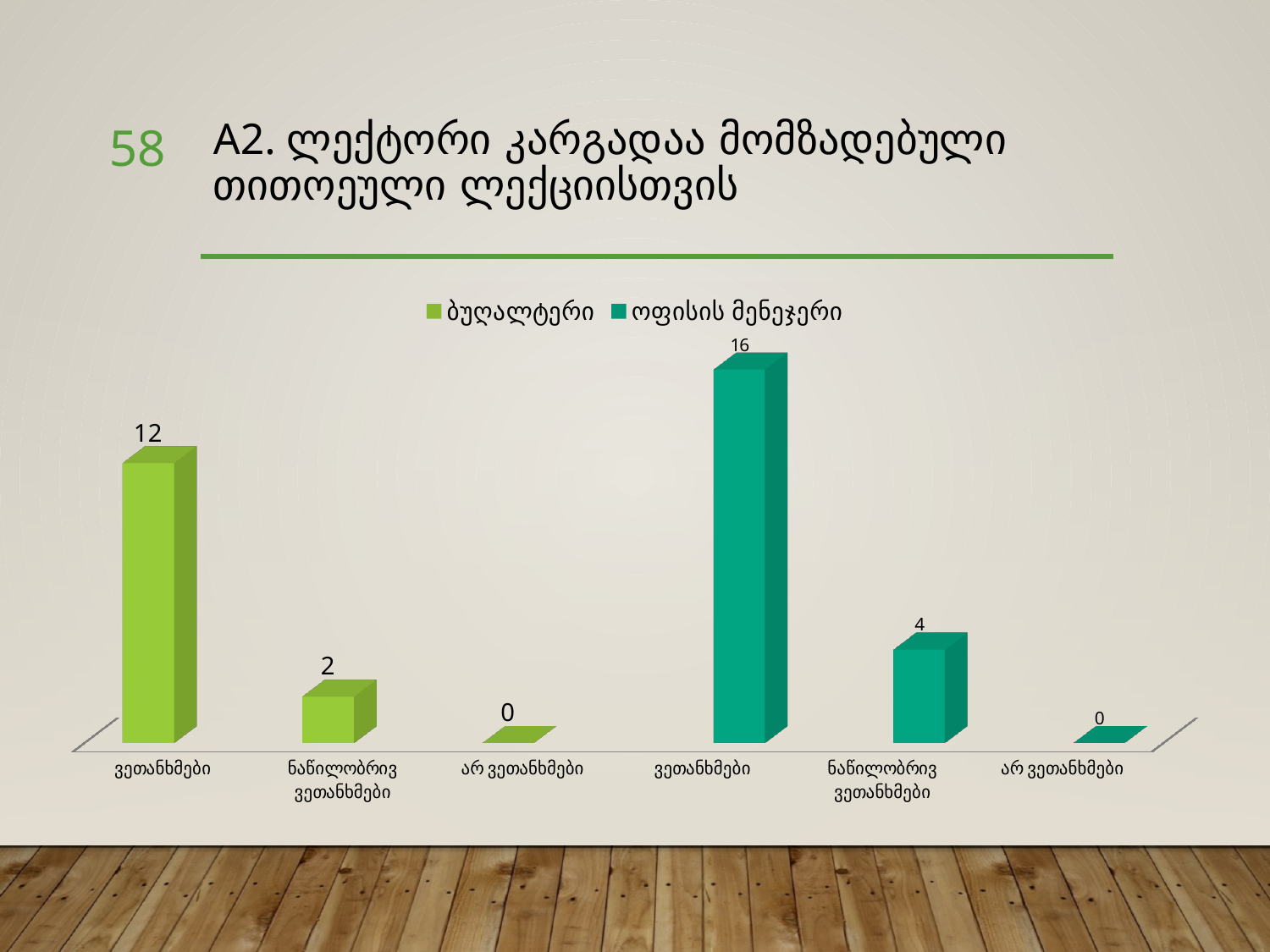
How many series does the legend list? 2 What is the value for ნაწილობრივ ვეთანხმები in the ოფისის მენეჯერი series? 4 What is the value for ვეთანხმები in the ბუღალტერი series? 12 What is the value for არ ვეთანხმები in the ბუღალტერი series? 0 How many categories are shown for each series? 3 What is the value for ვეთანხმები in the ოფისის მენეჯერი series? 16 What colour are the bars of the ოფისის მენეჯერი series? Teal green Which is larger: the ნაწილობრივ ვეთანხმები value for ბუღალტერი or for ოფისის მენეჯერი? ოფისის მენეჯერი What is the value for ნაწილობრივ ვეთანხმები in the ბუღალტერი series? 2 What is the difference between the ვეთანხმები values of the ოფისის მენეჯერი and ბუღალტერი series? 4 What kind of chart is shown on the slide? Bar chart Which category has the highest value in the ოფისის მენეჯერი series? ვეთანხმები